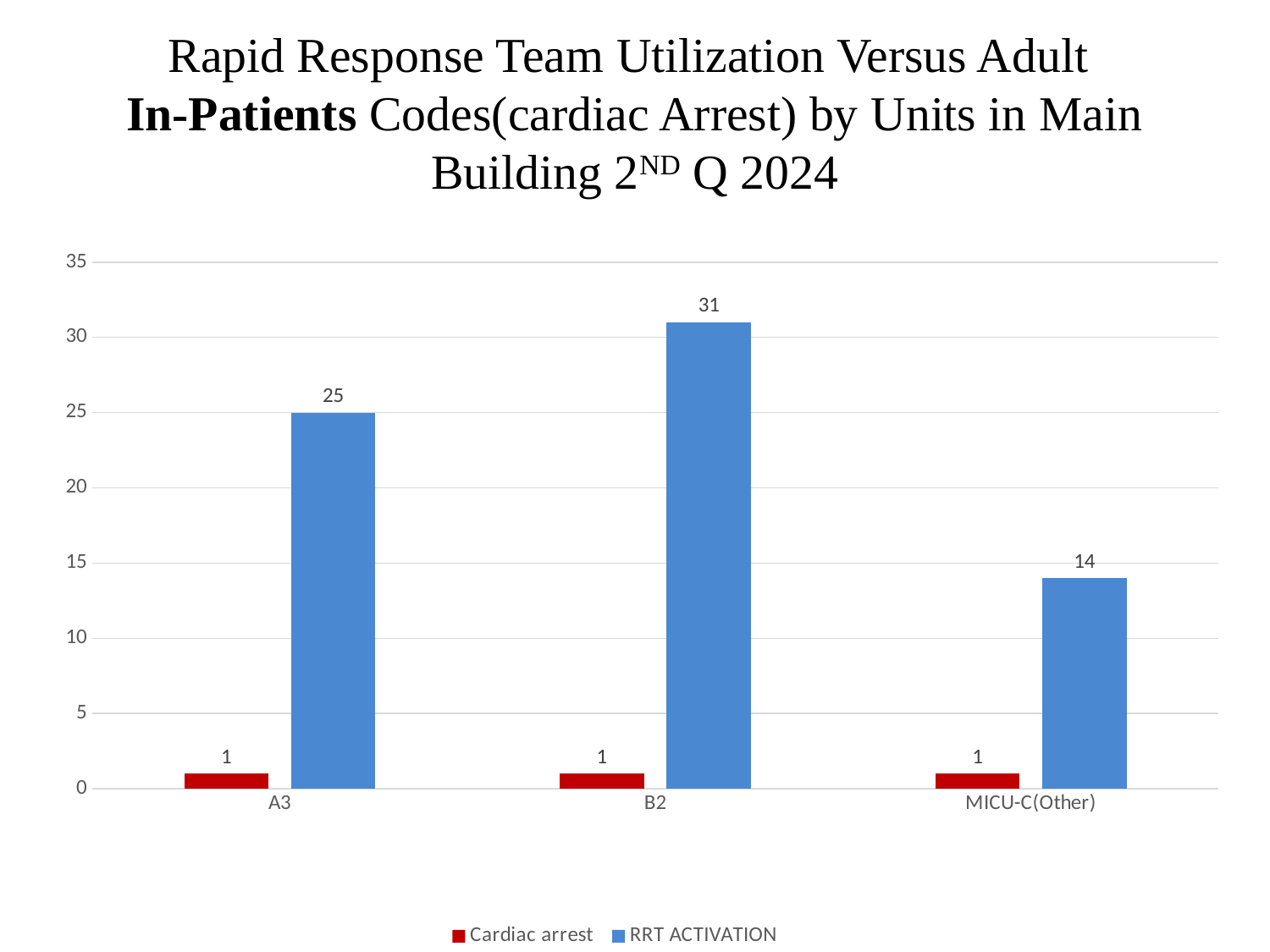
How many units are shown on the x axis? 3 What is the difference between the RRT ACTIVATION values for B2 and A3? 6 How many series does the legend list? 2 What kind of chart is shown on the slide? Bar chart What is the RRT ACTIVATION value for MICU-C(Other)? 14 Which unit has the lowest RRT ACTIVATION value? MICU-C(Other) Which is larger, the RRT ACTIVATION value for A3 or for MICU-C(Other)? A3 What is the Cardiac arrest value for B2? 1 What colour are the Cardiac arrest bars? Red What is the RRT ACTIVATION value for B2? 31 What is the RRT ACTIVATION value for A3? 25 Which unit has the highest RRT ACTIVATION value? B2